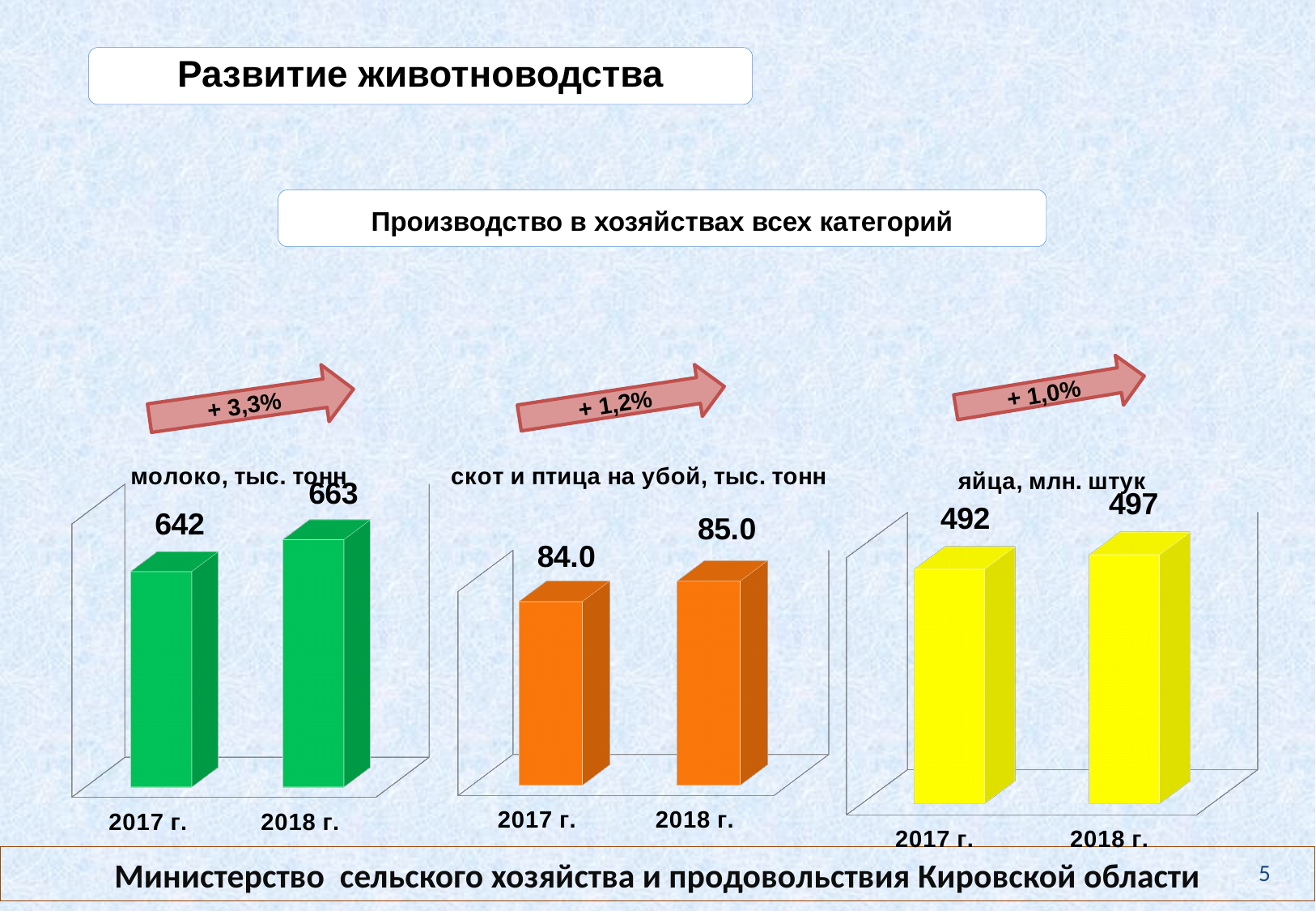
How many bars does the right chart (яйца, млн. штук) contain? 2 In the left chart (молоко, тыс. тонн), what is the value for 2017 г.? 642 In the right chart (яйца, млн. штук), what is the value for 2017 г.? 492 In the left chart (молоко, тыс. тонн), by how much does the 2018 г. value exceed the 2017 г. value? 21 In the middle chart (скот и птица на убой, тыс. тонн), what is the value for 2017 г.? 84.0 In the left chart (молоко, тыс. тонн), what is the value for 2018 г.? 663 In the middle chart (скот и птица на убой, тыс. тонн), which year has the higher value? 2018 г. In the right chart (яйца, млн. штук), what is the value for 2018 г.? 497 In the right chart (яйца, млн. штук), what is the difference between the 2018 г. and 2017 г. values? 5 In the left chart (молоко, тыс. тонн), do the values rise or fall from 2017 г. to 2018 г.? rise In the middle chart (скот и птица на убой, тыс. тонн), what is the value for 2018 г.? 85.0 What type of chart is used for the middle chart (скот и птица на убой, тыс. тонн)? bar chart